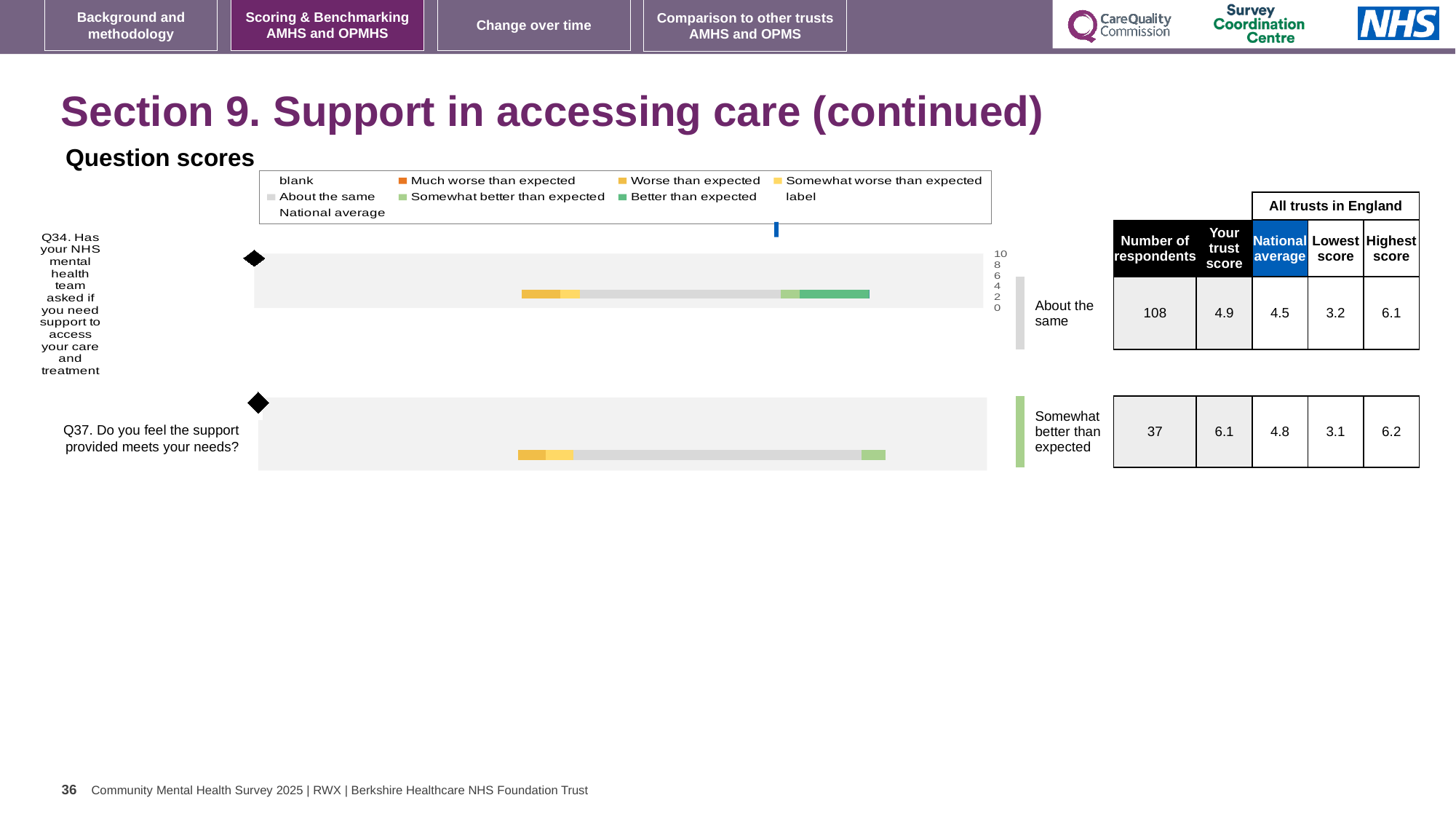
How many respondents answered Q37? 37 Which benchmark category is shown for Q37? Somewhat better than expected What is the highest score among all trusts in England for Q37? 6.2 What is the difference between the trust score and the national average for Q37? 1.3 Which question has the higher trust score, Q34 or Q37? Q37 Which question has the larger number of respondents, Q34 or Q37? Q34 What is the national average score for Q34? 4.5 What kind of chart is used to show the question scores on this slide? bar chart How many questions are plotted in the question scores chart? 2 What is the trust score for Q37 (Do you feel the support provided meets your needs)? 6.1 What colour does the legend use for 'Much worse than expected'? orange What is the trust score for Q34 (Has your NHS mental health team asked if you need support to access your care and treatment)? 4.9